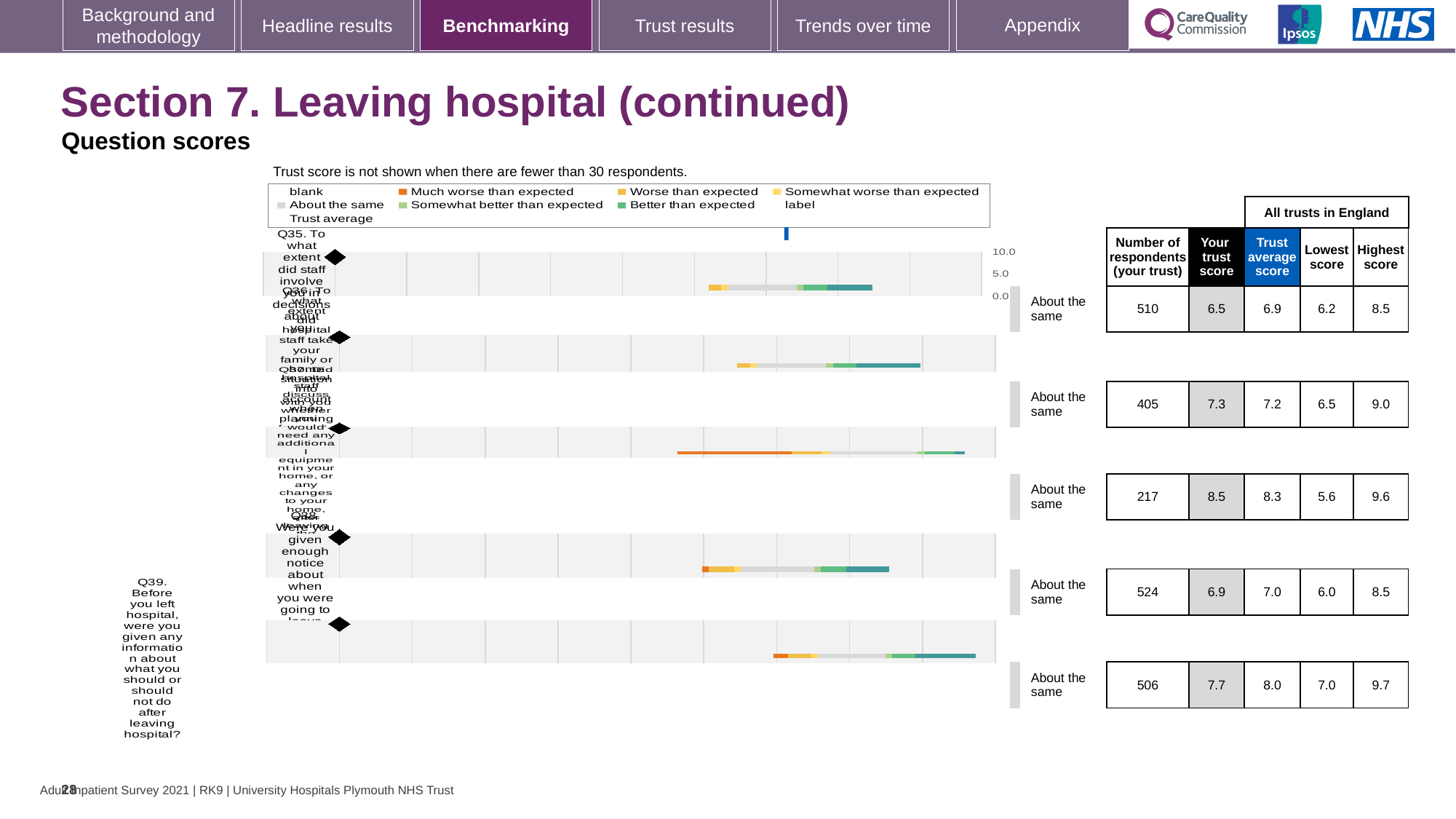
How many questions are shown on the chart? 5 What is the difference between your trust score and the trust average score for Q39? 0.3 What is the number of respondents (your trust) for Q39? 506 What is the legend entry shown in dark orange? Much worse than expected What is the lowest score among all trusts in England for Q37? 5.6 What benchmark category is shown for Q38? About the same What is your trust score for Q37? 8.5 What is the highest score among all trusts in England for Q39? 9.7 Is your trust score for Q36 higher or lower than the trust average score for Q36? higher What is the trust average score for all trusts in England for Q35? 6.9 Which question has the fewest respondents (your trust)? Q37 Which question has the highest 'Your trust score'? Q37